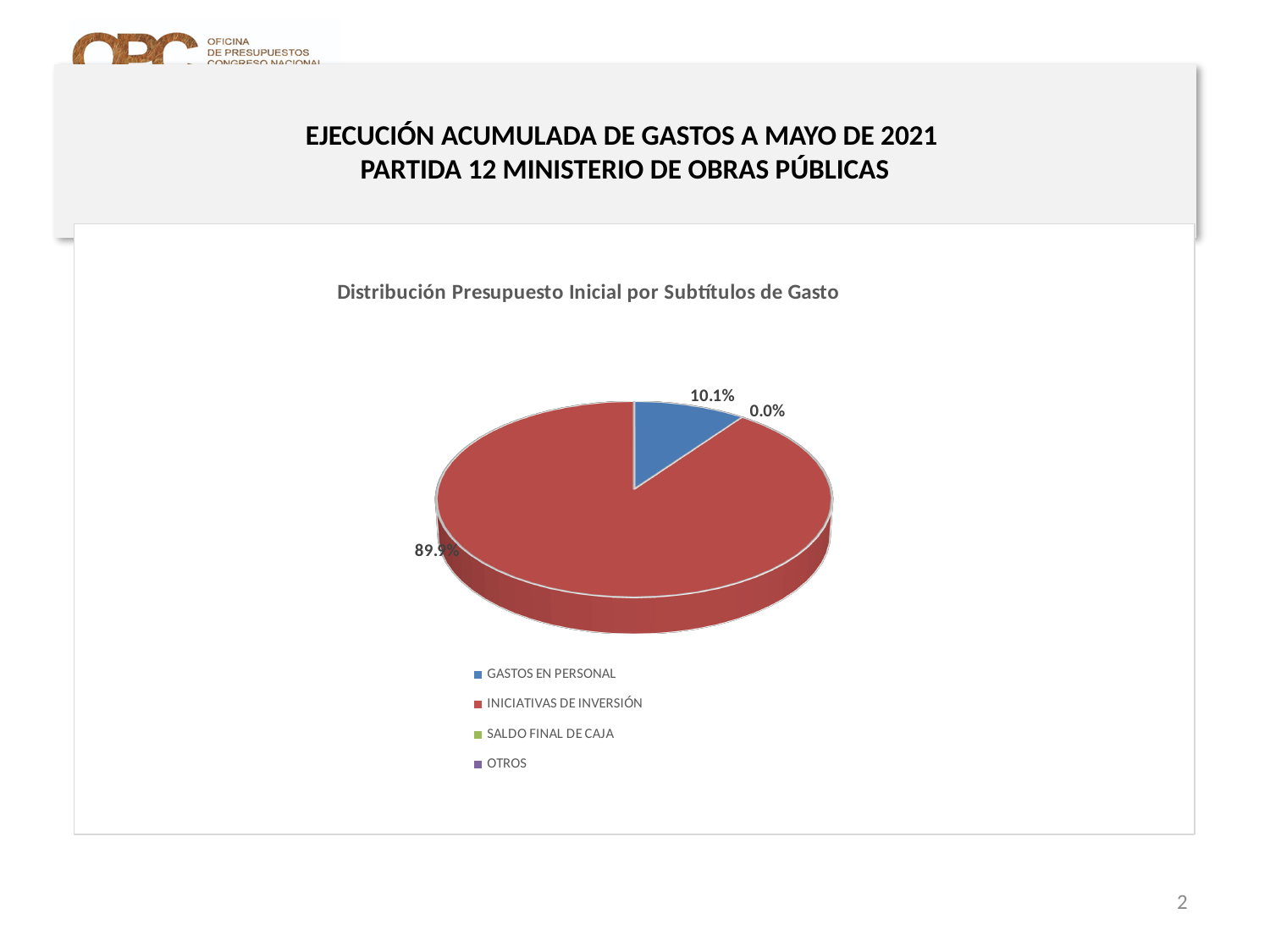
What is the smallest percentage label printed on the pie chart? 0.0% What colour is the slice for INICIATIVAS DE INVERSIÓN? Red How many categories does the legend list? 4 What kind of chart is shown on the slide? Pie chart What share of the initial budget does INICIATIVAS DE INVERSIÓN represent? 89.9% What is the difference in percentage points between INICIATIVAS DE INVERSIÓN and GASTOS EN PERSONAL? 79.8 percentage points Which is larger, the share for GASTOS EN PERSONAL or the share for INICIATIVAS DE INVERSIÓN? INICIATIVAS DE INVERSIÓN What share of the initial budget does GASTOS EN PERSONAL represent? 10.1% Is the share for GASTOS EN PERSONAL greater or less than 50%? less What is the title of the chart? Distribución Presupuesto Inicial por Subtítulos de Gasto What do the shares for GASTOS EN PERSONAL and INICIATIVAS DE INVERSIÓN add up to? 100.0% Which category has the largest share of the pie? INICIATIVAS DE INVERSIÓN